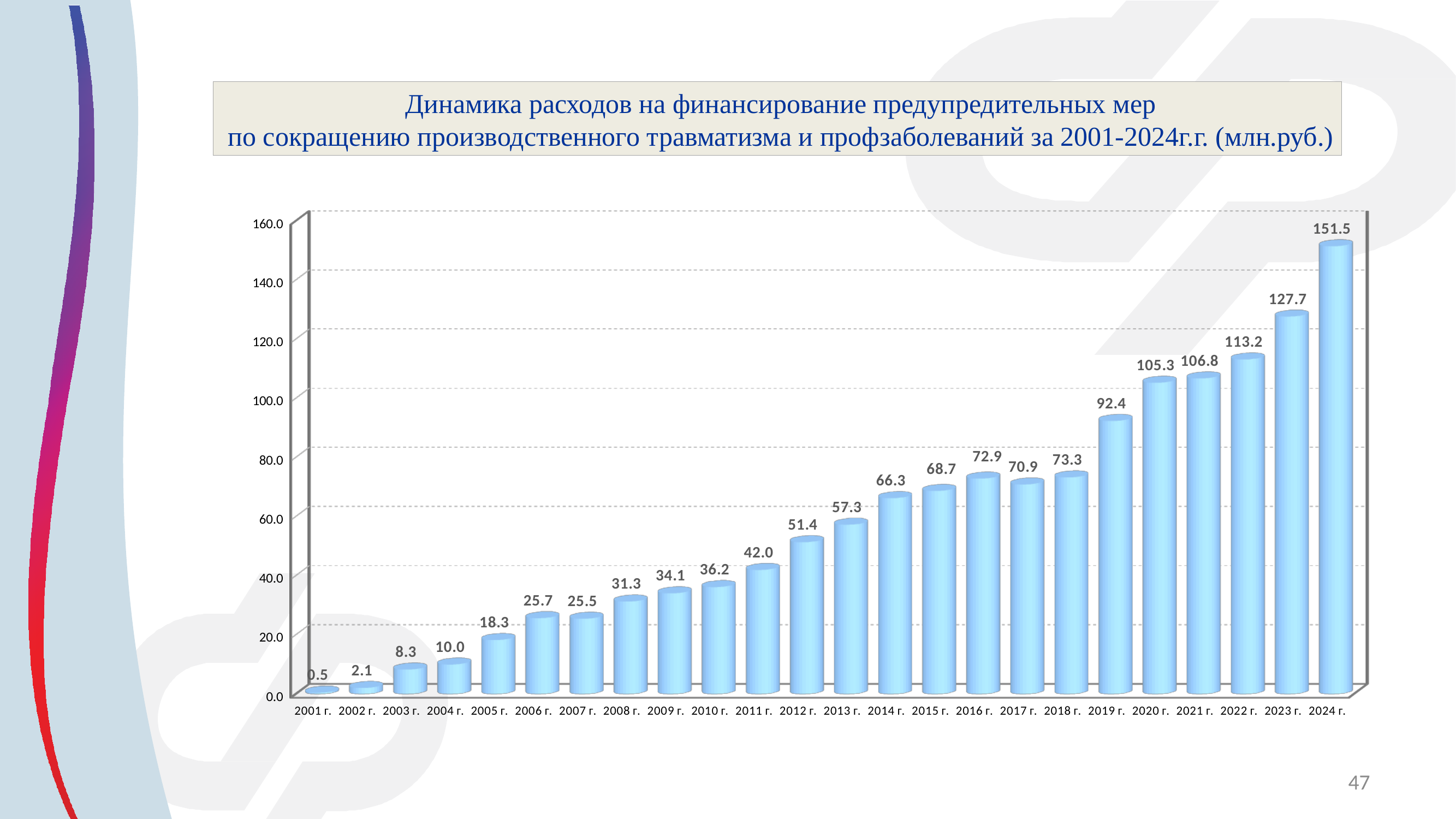
Do the values generally rise or fall from 2001 г. to 2024 г.? rise What kind of chart is shown on the slide? bar chart Which year has the lowest value? 2001 г. Is the value for 2022 г. greater or less than 100? greater What is the difference between the values for 2024 г. and 2023 г.? 23.8 What is the value for 2012 г.? 51.4 How many years are shown on the x axis? 24 Which year has the highest value? 2024 г. What is the value for 2024 г.? 151.5 What is the difference between the values for 2019 г. and 2018 г.? 19.1 Which is larger, the value for 2016 г. or the value for 2017 г.? 2016 г. What is the value for 2005 г.? 18.3